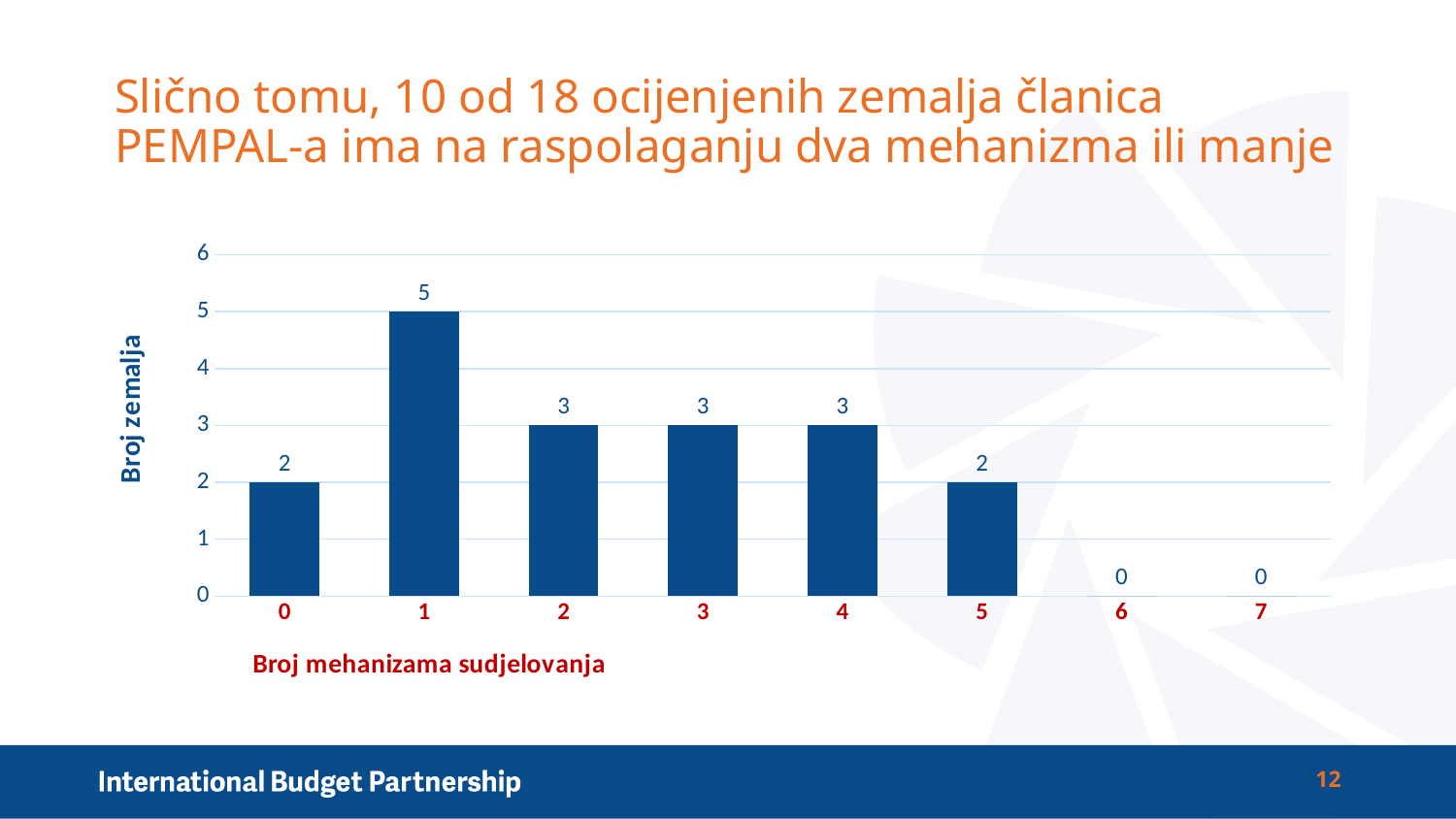
What is the number of countries (Broj zemalja) for 1 participation mechanism? 5 What is the total number of countries for 2, 3 and 4 participation mechanisms combined? 9 What is the label of the x axis of the chart? Broj mehanizama sudjelovanja Which has more countries: 4 participation mechanisms or 5 participation mechanisms? 4 What is the number of countries for 7 participation mechanisms? 0 What is the number of countries for 5 participation mechanisms? 2 Which number of participation mechanisms has the highest number of countries? 1 What is the difference between the number of countries with 1 mechanism and the number with 2 mechanisms? 2 How many categories are shown on the x axis of the chart? 8 What kind of chart is shown on the slide? bar chart What is the number of countries for 0 participation mechanisms? 2 What is the label of the y axis of the chart? Broj zemalja